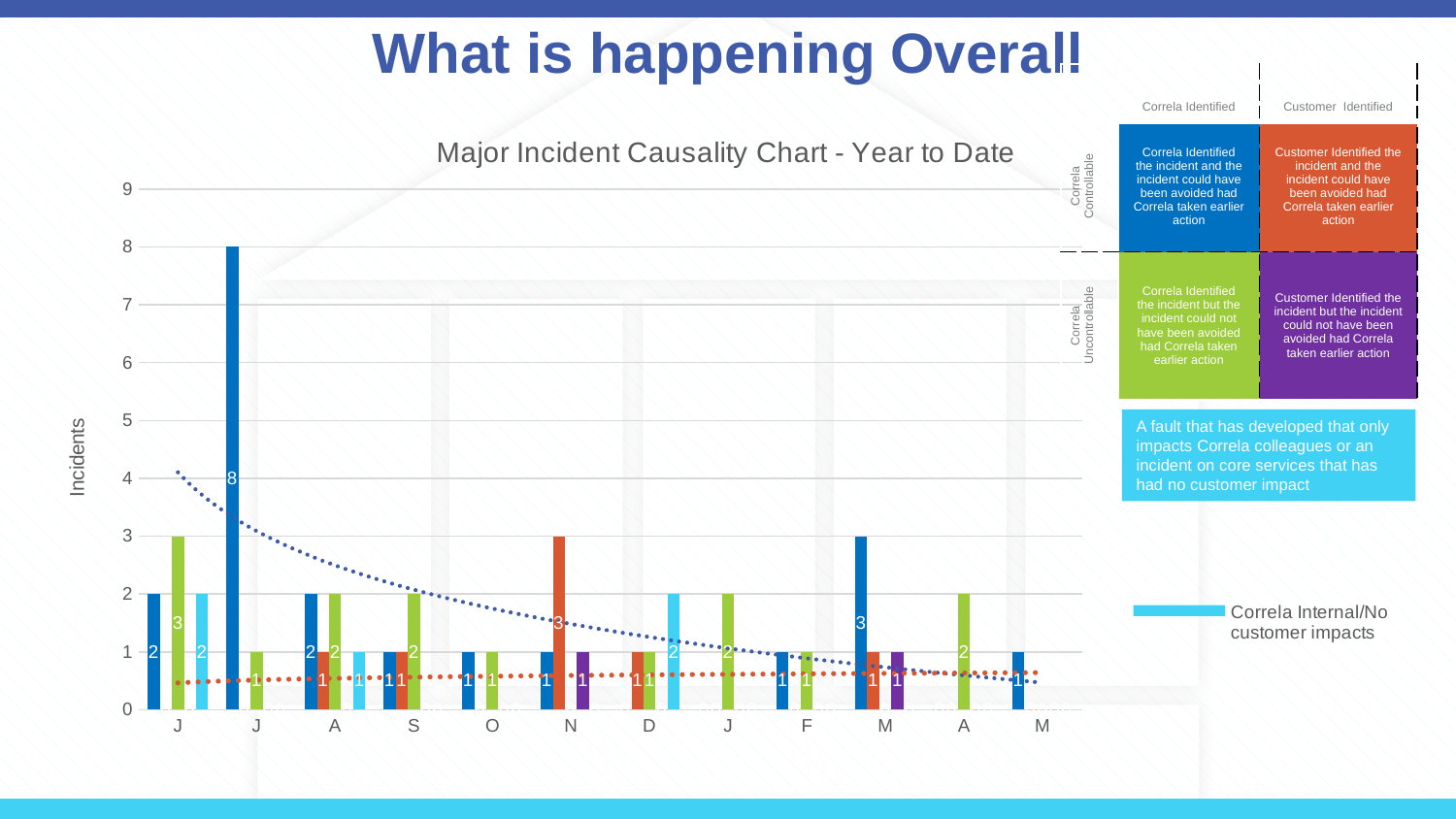
What is the highest value shown by any bar in the Major Incident Causality Chart? 8 Does the blue dotted trend line rise or fall from left to right across the chart? fall What kind of chart is the Major Incident Causality Chart - Year to Date? bar chart How many month categories are shown along the x axis of the chart? 12 What is the label on the vertical axis of the chart? Incidents For the first 'J' month, which is larger: the dark blue bar or the green bar? the green bar What is the value of the green bar for the first 'J' month on the x axis? 3 What is the value of the dark blue bar for the first 'M' month on the x axis? 3 What is the difference between the dark blue bar for the second 'J' month (8) and the green bar for the first 'J' month (3)? 5 What is the value of the orange bar for the 'N' month? 3 What is the value of the dark blue bar for the second 'J' month on the x axis? 8 What is the title of the chart on the slide? Major Incident Causality Chart - Year to Date